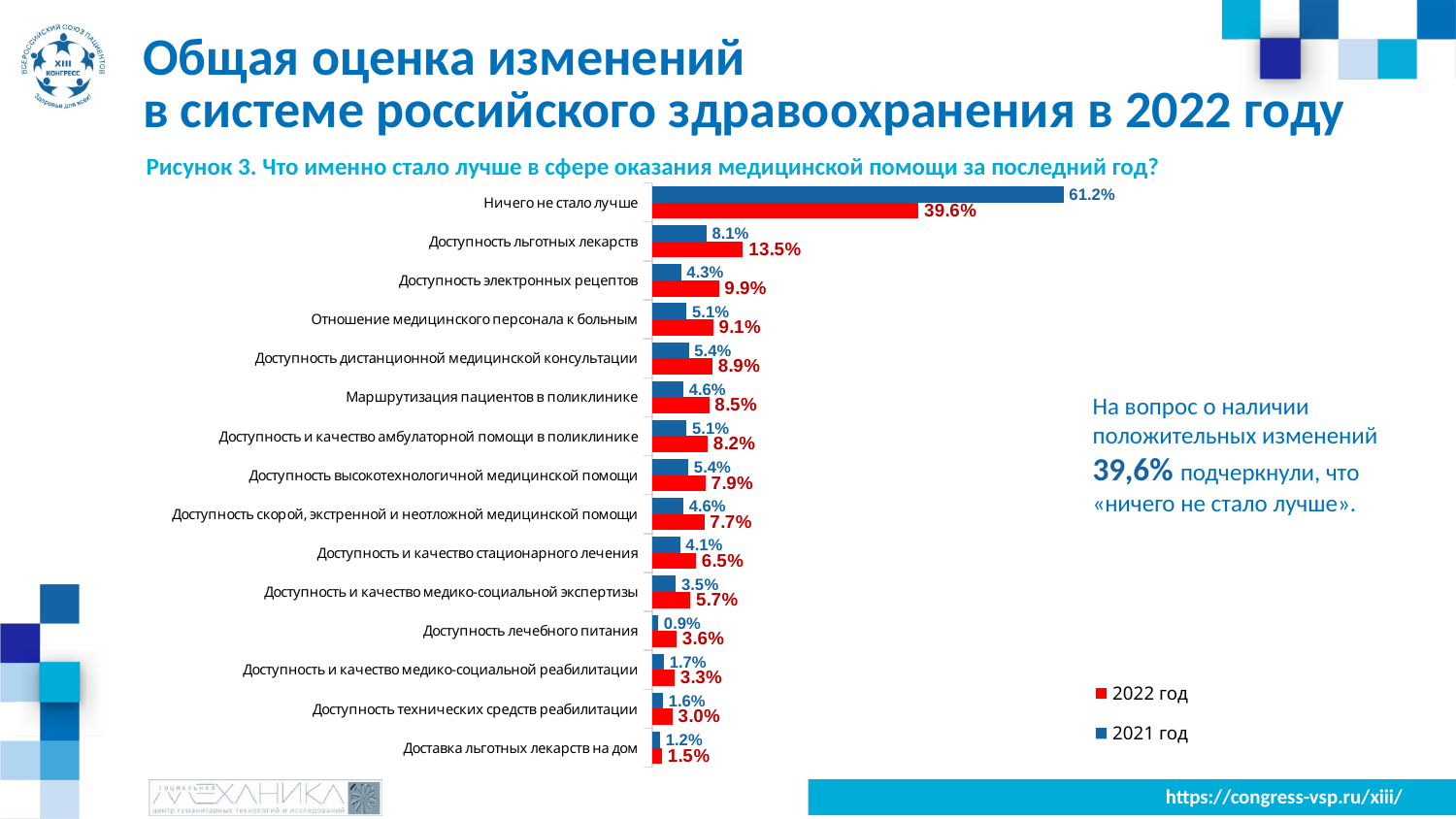
Which colour represents the 2021 год series in the chart? blue How many categories are shown in the chart? 15 How many series does the legend list? 2 What type of chart is shown on the slide? bar chart What is the difference between the 2022 год and 2021 год values for "Доступность льготных лекарств"? 5.4% What is the difference between the 2021 год and 2022 год values for "Ничего не стало лучше"? 21.6% What is the value for "Доступность лечебного питания" in the 2021 год series? 0.9% What is the value for "Ничего не стало лучше" in the 2021 год series? 61.2% What is the value for "Доступность льготных лекарств" in the 2022 год series? 13.5% Which is larger for "Доступность электронных рецептов": the 2022 год value or the 2021 год value? 2022 год Which category has the lowest value in the 2022 год series? Доставка льготных лекарств на дом Which category has the highest value in the 2022 год series? Ничего не стало лучше